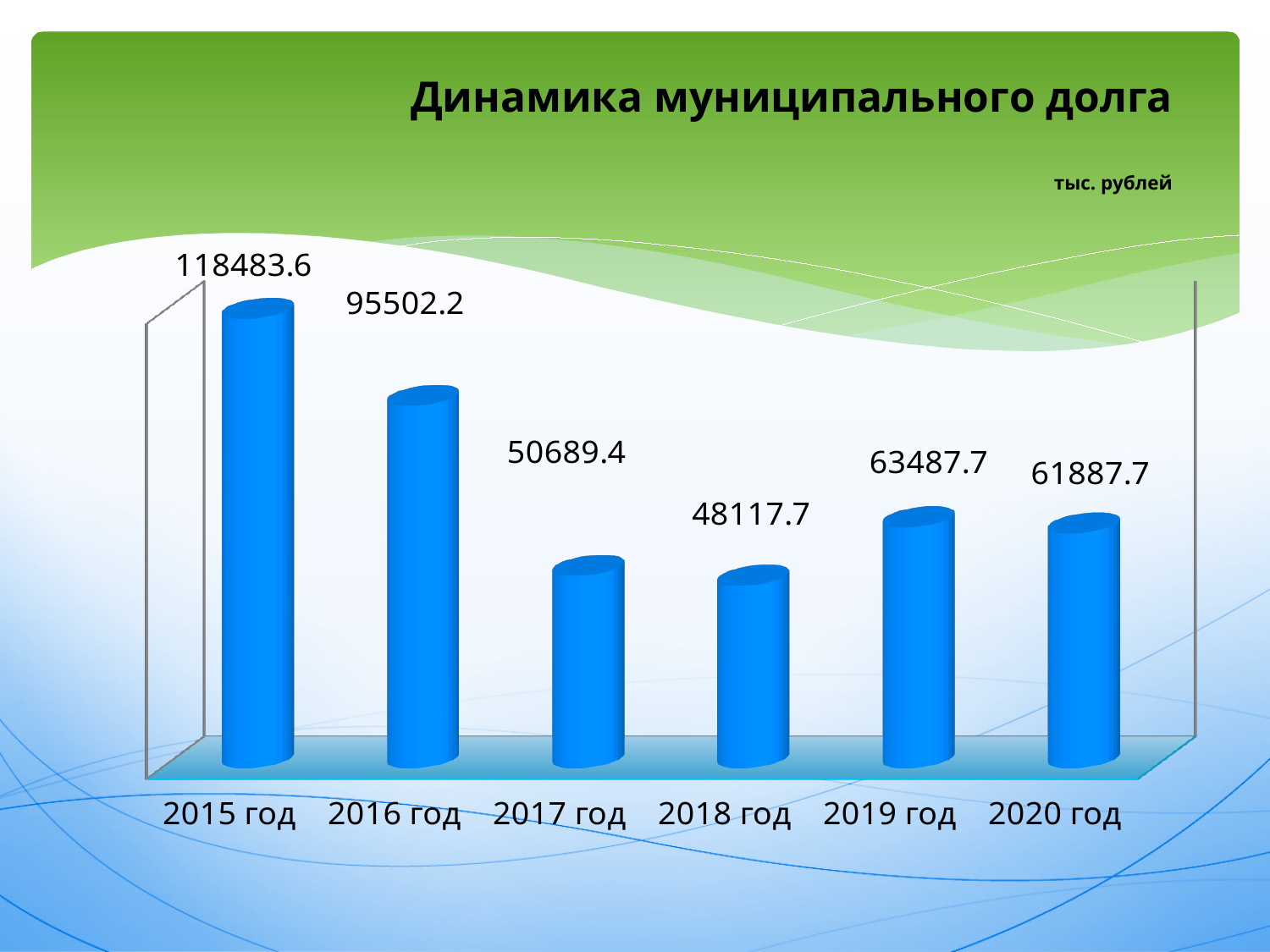
What is the value for 2020 год? 61887.7 Do the values rise or fall from 2015 год to 2018 год? fall Which year has the highest value? 2015 год What is the value for 2015 год? 118483.6 What kind of chart is this? bar chart Which year has the lowest value? 2018 год Which is larger, the value for 2017 год or the value for 2019 год? 2019 год What is the difference between the values for 2019 год and 2020 год? 1600 What is the difference between the values for 2015 год and 2016 год? 22981.4 What is the value for 2018 год? 48117.7 What is the title of the chart? Динамика муниципального долга How many years are shown on the chart? 6